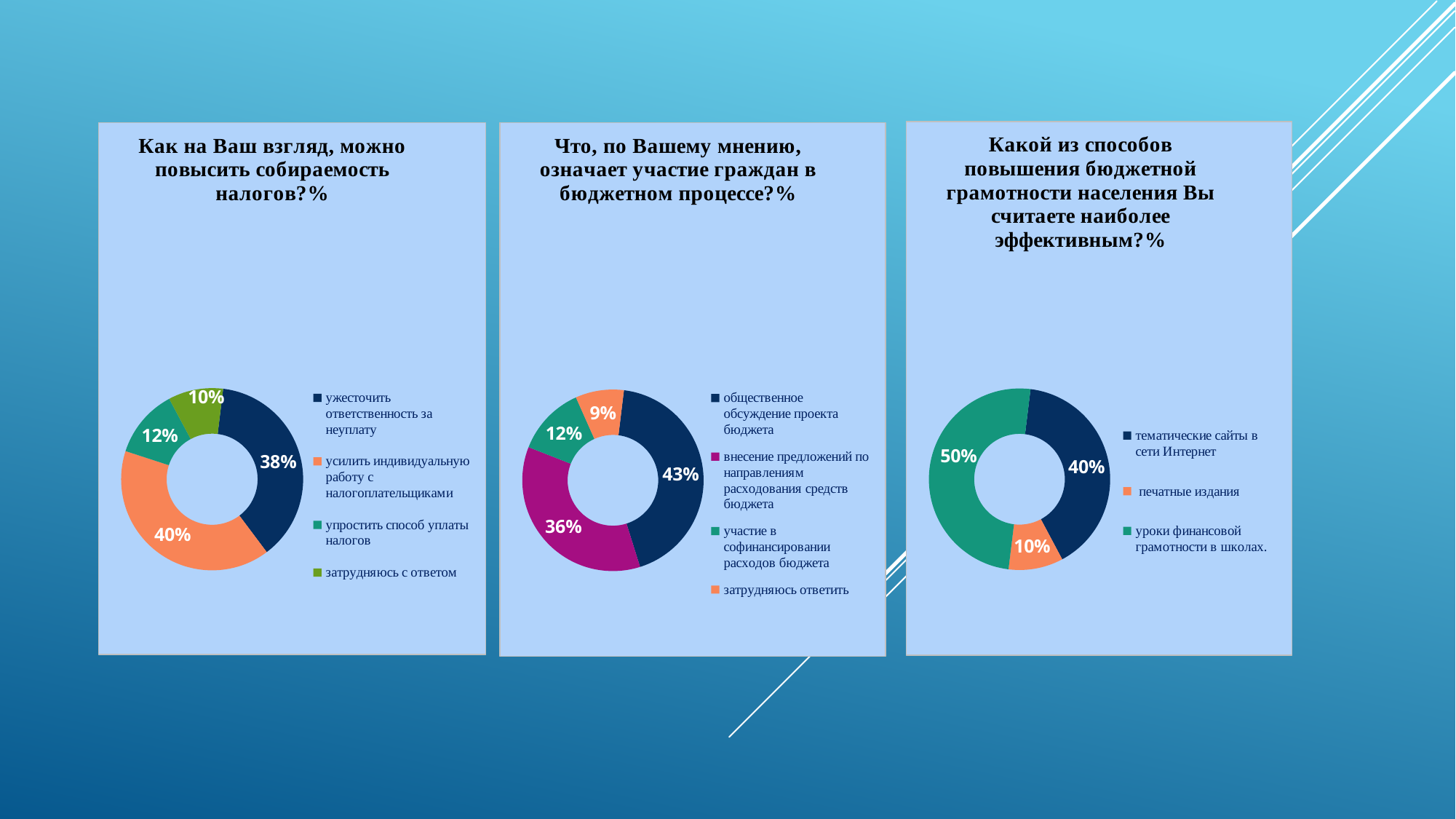
In the middle chart, which is larger: "внесение предложений по направлениям расходования средств бюджета" or "участие в софинансировании расходов бюджета"? внесение предложений по направлениям расходования средств бюджета In the left chart, what is the difference between the shares for "усилить индивидуальную работу с налогоплательщиками" and "ужесточить ответственность за неуплату"? 2% In the right chart, what is the difference between the shares for "уроки финансовой грамотности в школах" and "тематические сайты в сети Интернет"? 10% In the middle chart, what share is shown for "затрудняюсь ответить"? 9% In the left chart, which category has the smallest share? затрудняюсь с ответом In the right chart, which category has the smallest share? печатные издания In the right chart ("Какой из способов повышения бюджетной грамотности населения Вы считаете наиболее эффективным?"), what share is shown for "уроки финансовой грамотности в школах"? 50% In the middle chart ("Что, по Вашему мнению, означает участие граждан в бюджетном процессе?"), what share is shown for "общественное обсуждение проекта бюджета"? 43% In the middle chart, which category has the largest share? общественное обсуждение проекта бюджета In the left chart, how many categories does the legend list? 4 In the left chart ("Как на Ваш взгляд, можно повысить собираемость налогов?"), what share is shown for "усилить индивидуальную работу с налогоплательщиками"? 40% What type of chart is used on the right of the slide? Doughnut (pie) chart